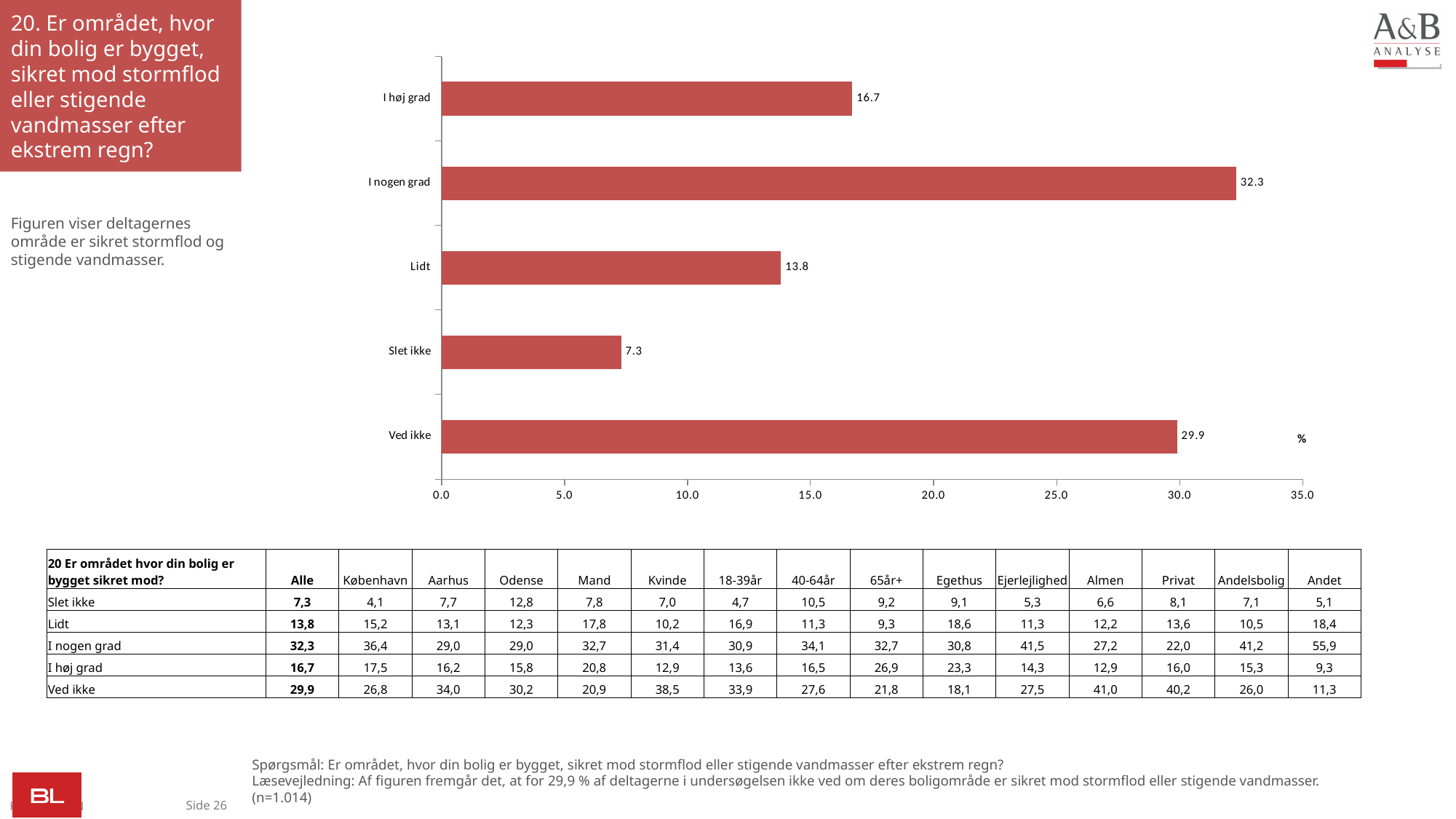
Which category has the lowest value? Slet ikke Which is larger, the value for "I høj grad" or the value for "Lidt"? I høj grad What is the value for "Ved ikke"? 29.9 What kind of chart is shown on the slide? Bar chart What is the maximum value shown on the horizontal axis of the chart? 35.0 Is the value for "Ved ikke" greater or less than 25.0? greater What is the value for "Slet ikke"? 7.3 What is the difference between the values for "I nogen grad" and "Ved ikke"? 2.4 What is the value for "I nogen grad"? 32.3 How many categories are shown in the bar chart? 5 Which category has the highest value? I nogen grad What is the value for "Lidt"? 13.8